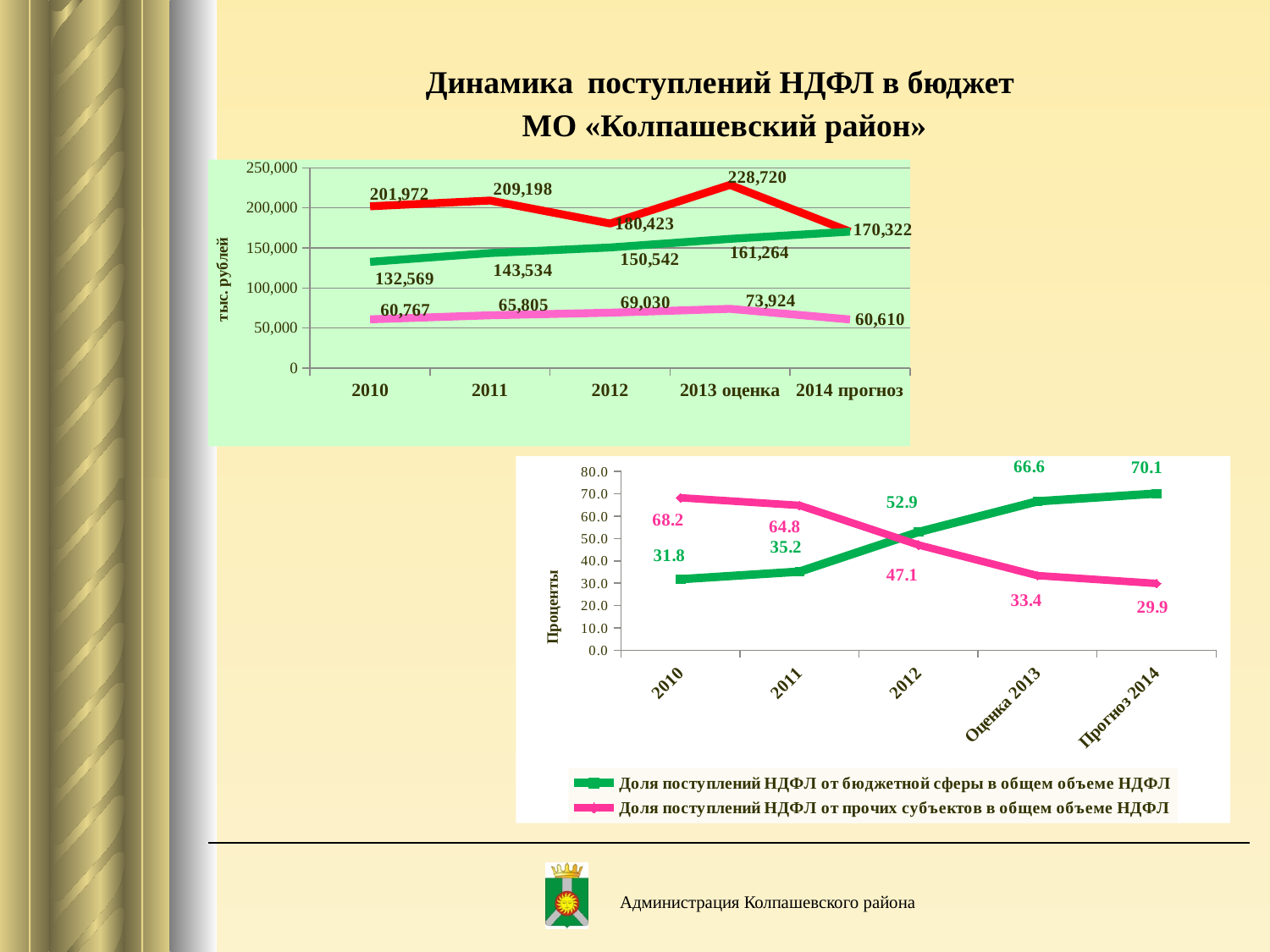
In the top chart, in which year does the red line reach its highest value? 2013 оценка In the top chart, what is the value of the pink line for 2014 прогноз? 60,610 In the bottom chart, what is the value of 'Доля поступлений НДФЛ от прочих субъектов в общем объеме НДФЛ' for Прогноз 2014? 29.9 In the bottom chart, does the share of НДФЛ from the budget sector (green line) rise or fall from 2010 to Прогноз 2014? Rise How many series does the legend of the bottom chart list? 2 What kind of chart is the bottom chart? Line chart How many categories are shown on the x axis of the top chart? 5 In the top chart, what is the value of the green line for 2011? 143,534 In the top chart, what is the difference between the red line's values for 2013 оценка and 2012? 48,297 In the top chart, what is the value of the red line for 2013 оценка? 228,720 In the bottom chart, what is the value of 'Доля поступлений НДФЛ от бюджетной сферы в общем объеме НДФЛ' for 2012? 52.9 In the top chart, in which year is the pink line at its lowest value? 2014 прогноз